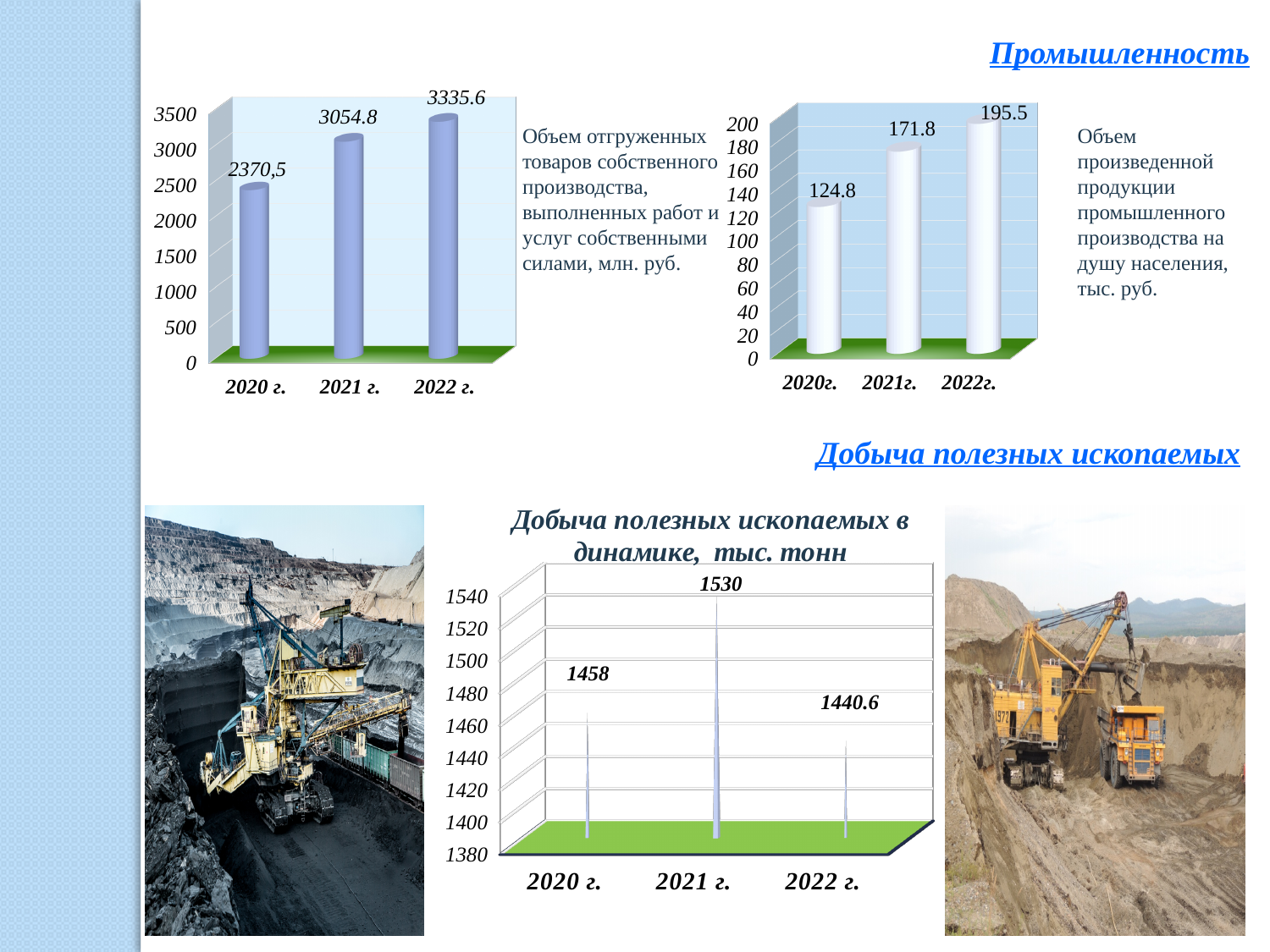
In the chart titled 'Добыча полезных ископаемых в динамике, тыс. тонн', which year has the lowest value? 2022 г. In the chart titled 'Добыча полезных ископаемых в динамике, тыс. тонн', which is larger: the value for 2020 г. or 2022 г.? 2020 г. In the top-left chart (volume of shipped goods, mln rub.), what is the difference between the 2022 г. and 2021 г. values? 280.8 In the top-left chart (volume of shipped goods, mln rub.), what is the value for 2021 г.? 3054.8 How many years are shown on the x axis of the chart titled 'Добыча полезных ископаемых в динамике, тыс. тонн'? 3 In the top-right chart (industrial production per capita, thousand rub.), what is the difference between the 2021г. and 2020г. values? 47 In the top-left chart (volume of shipped goods, mln rub.), what is the value for 2020 г.? 2370,5 In the top-left chart (volume of shipped goods, mln rub.), which year has the highest value? 2022 г. In the top-right chart (industrial production per capita, thousand rub.), do the values rise or fall from 2020г. to 2022г.? rise In the chart titled 'Добыча полезных ископаемых в динамике, тыс. тонн', what is the value for 2021 г.? 1530 In the top-right chart (industrial production per capita, thousand rub.), what is the value for 2022г.? 195.5 In the top-right chart (industrial production per capita, thousand rub.), which year has the lowest value? 2020г.